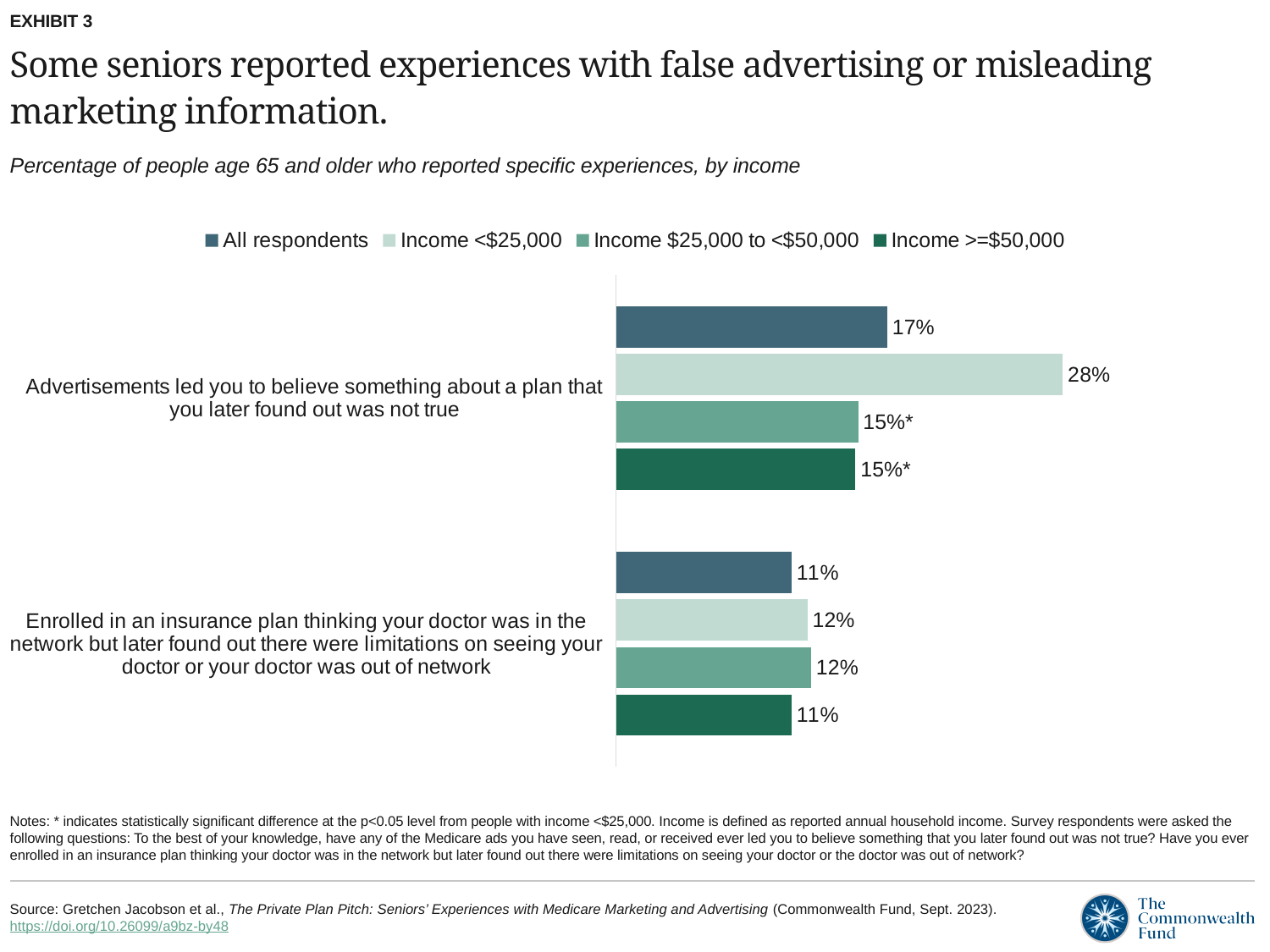
How many experience categories are shown on the chart? 2 What kind of chart is shown on the slide? Bar chart What is the difference between the Income <$25,000 group and all respondents for the advertisements-led-you-to-believe-something-untrue experience? 11 percentage points How many series does the legend list? 4 For the Income <$25,000 group, what is the difference between the two experiences shown? 16 percentage points What percentage of all respondents reported that advertisements led them to believe something about a plan that they later found out was not true? 17% Which is larger for the Income $25,000 to <$50,000 group: the percentage for the advertisements experience or the percentage for the doctor-network experience? The advertisements experience What percentage of respondents with income >=$50,000 reported enrolling in a plan thinking their doctor was in the network but later finding limitations? 11% What percentage of respondents with income <$25,000 reported that advertisements led them to believe something about a plan that was not true? 28% What percentage of respondents with income $25,000 to <$50,000 reported enrolling in a plan thinking their doctor was in the network but later finding limitations? 12% Which income group had the highest percentage reporting that advertisements led them to believe something about a plan that was not true? Income <$25,000 Which values on the chart are marked with an asterisk? 15%* for Income $25,000 to <$50,000 and 15%* for Income >=$50,000 in the advertisements category